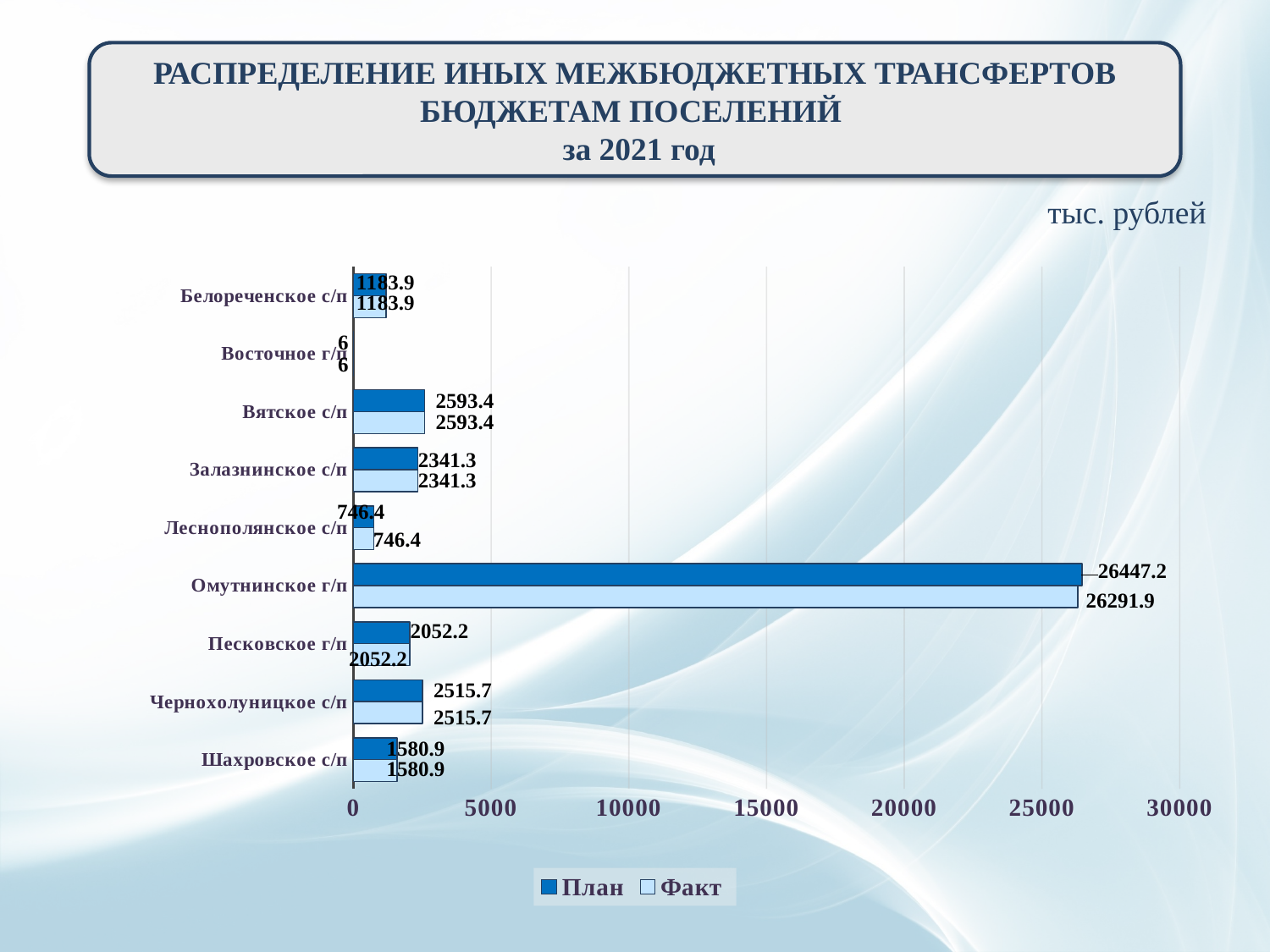
What is the difference between the План and Факт values for Омутнинское г/п? 155.3 What is the Факт value for Омутнинское г/п? 26291.9 What is the Факт value for Вятское с/п? 2593.4 Which is larger, the Факт value for Чернохолуницкое с/п or the Факт value for Песковское г/п? Чернохолуницкое с/п Is the План value for Омутнинское г/п greater or less than 25000? greater What is the План value for Лесополянское с/п? 746.4 What kind of chart is shown on the slide? bar chart How many series does the legend list? 2 Which category has the lowest Факт value? Восточное г/п How many categories are shown on the chart? 9 What is the План value for Омутнинское г/п? 26447.2 Which category has the highest План value? Омутнинское г/п